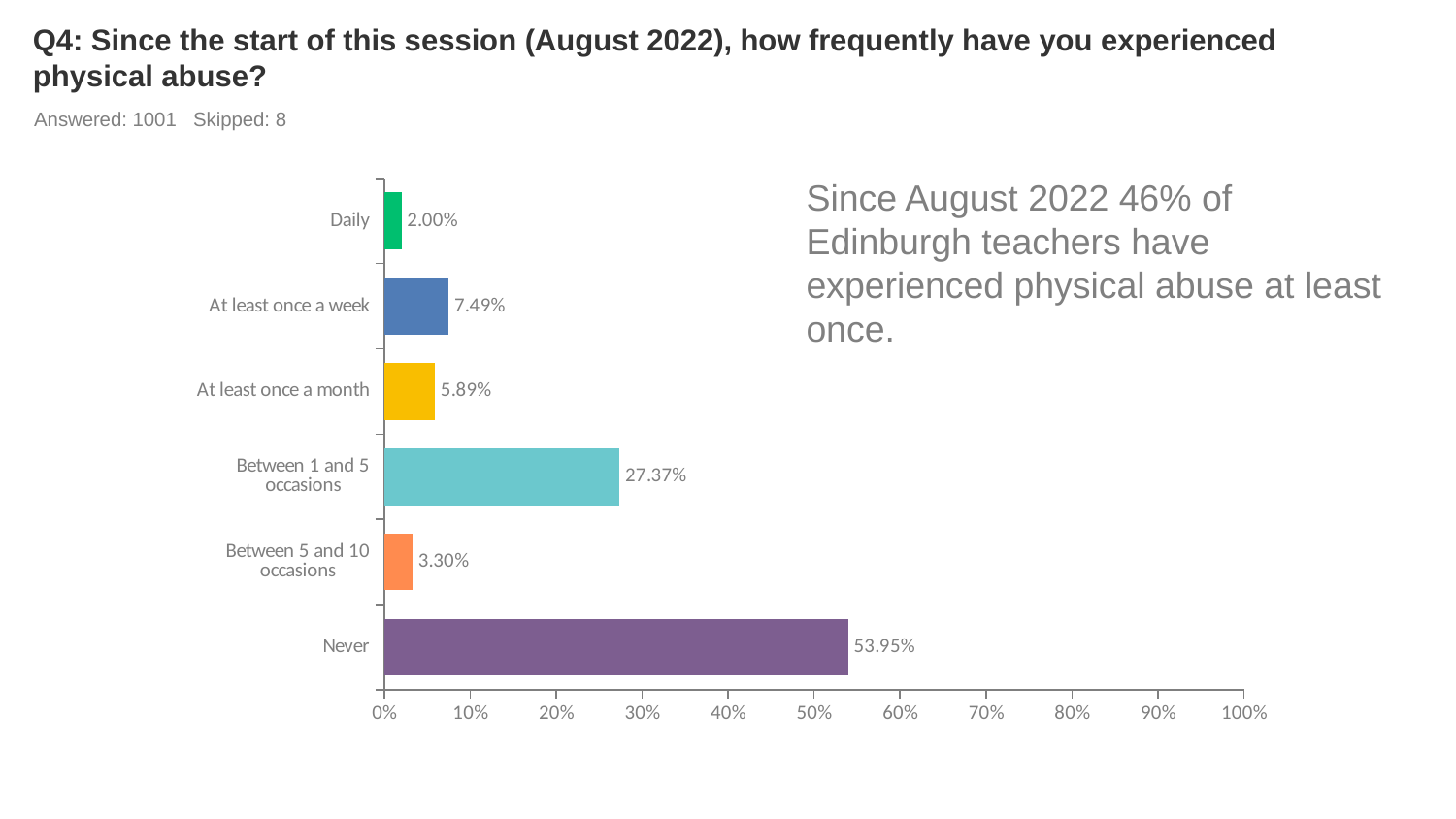
What is the difference between the values for "Never" and "Between 1 and 5 occasions"? 26.58% Is the value for "Never" greater or less than 50%? greater How many respondents answered the question, according to the slide? 1001 What percentage of respondents answered "Daily"? 2.00% How many categories are shown in the chart? 6 What kind of chart is shown on the slide? Bar chart What is the value for "Never"? 53.95% What is the value for "Between 1 and 5 occasions"? 27.37% Which is larger, the value for "At least once a week" or "At least once a month"? At least once a week Which category has the lowest value? Daily Which category has the highest value? Never What is the value for "At least once a week"? 7.49%